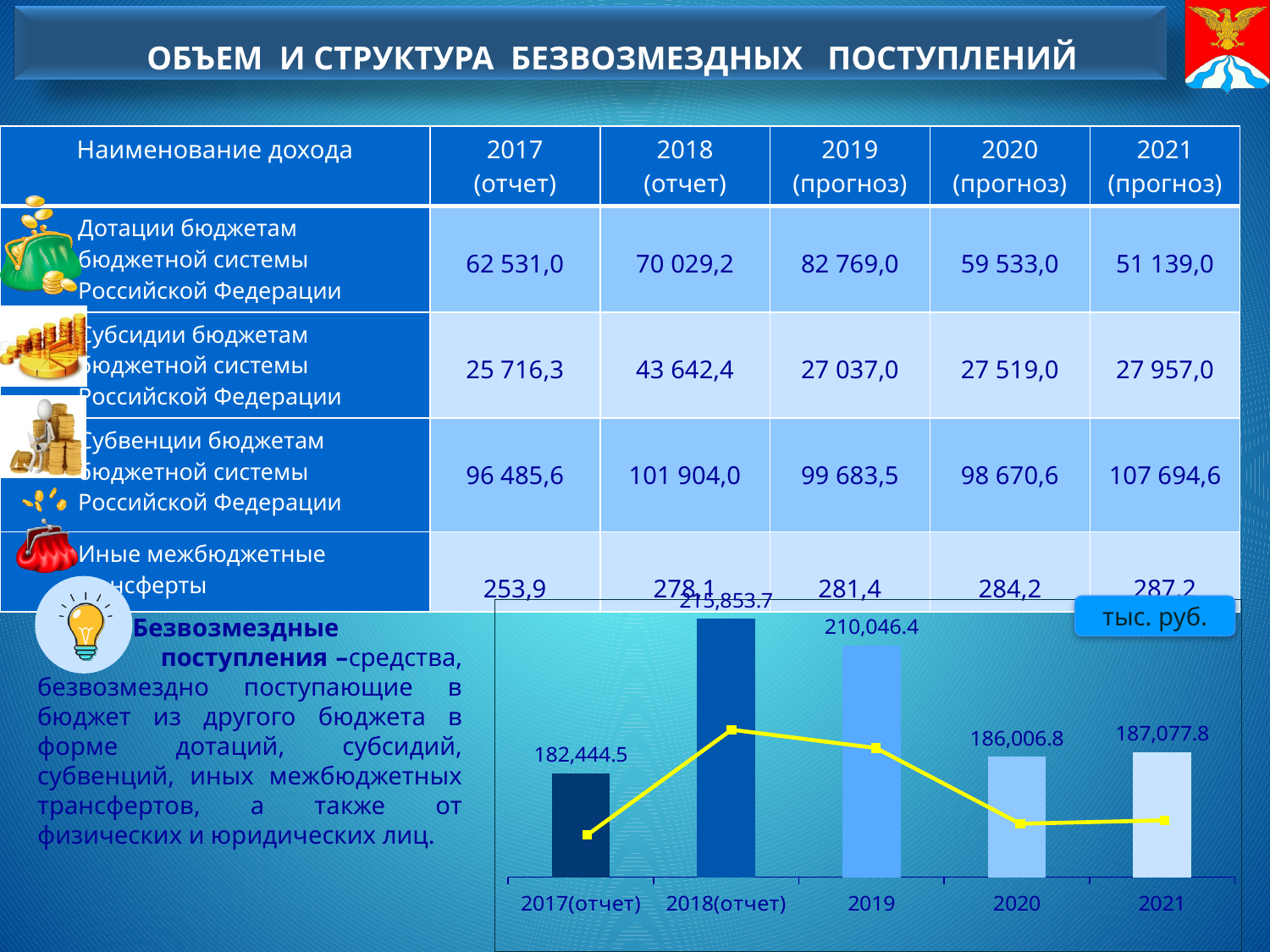
What value is shown for 2021 in the chart at the bottom of the slide? 187,077.8 In the chart at the bottom of the slide, which is larger: the value for 2019 or the value for 2021? 2019 What value is shown for 2020 in the chart at the bottom of the slide? 186,006.8 How many years (bars) are shown in the chart at the bottom of the slide? 5 What value is shown for 2017(отчет) in the chart at the bottom of the slide? 182,444.5 What unit label is shown in the top-right corner of the chart at the bottom of the slide? тыс. руб. In the chart at the bottom of the slide, what is the difference between the values for 2018(отчет) and 2017(отчет)? 33,409.2 What value is shown for 2018(отчет) in the chart at the bottom of the slide? 215,853.7 What value is shown for 2019 in the chart at the bottom of the slide? 210,046.4 In the chart at the bottom of the slide, which year has the lowest value? 2017(отчет) In the chart at the bottom of the slide, which year has the highest value? 2018(отчет) In the chart at the bottom of the slide, what is the difference between the values for 2019 and 2020? 24,039.6